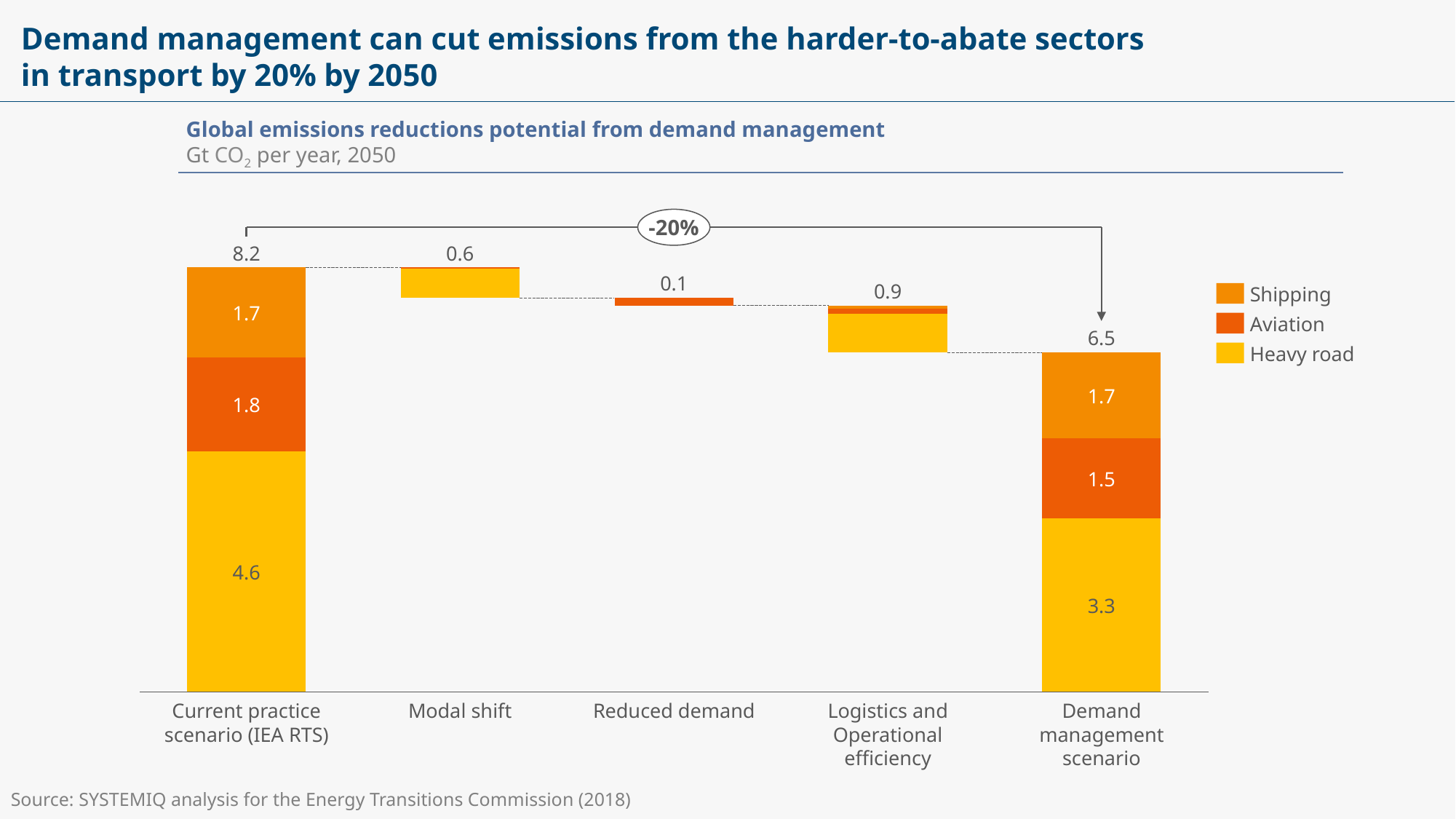
What is the value shown for Modal shift? 0.6 What is the Heavy road value in the Current practice scenario (IEA RTS)? 4.6 What is the total value of the Current practice scenario (IEA RTS) bar? 8.2 What is the value shown for Reduced demand? 0.1 What percentage reduction is shown in the callout between the two scenario bars? -20% Which of the three reduction steps (Modal shift, Reduced demand, Logistics and Operational efficiency) has the largest value? Logistics and Operational efficiency How many series does the legend list? 3 What is the difference between the Current practice scenario total and the Demand management scenario total? 1.7 What is the total value of the Demand management scenario bar? 6.5 What is the Aviation value in the Demand management scenario? 1.5 Is the Aviation value larger in the Current practice scenario or in the Demand management scenario? Current practice scenario Which of the three reduction steps (Modal shift, Reduced demand, Logistics and Operational efficiency) has the smallest value? Reduced demand